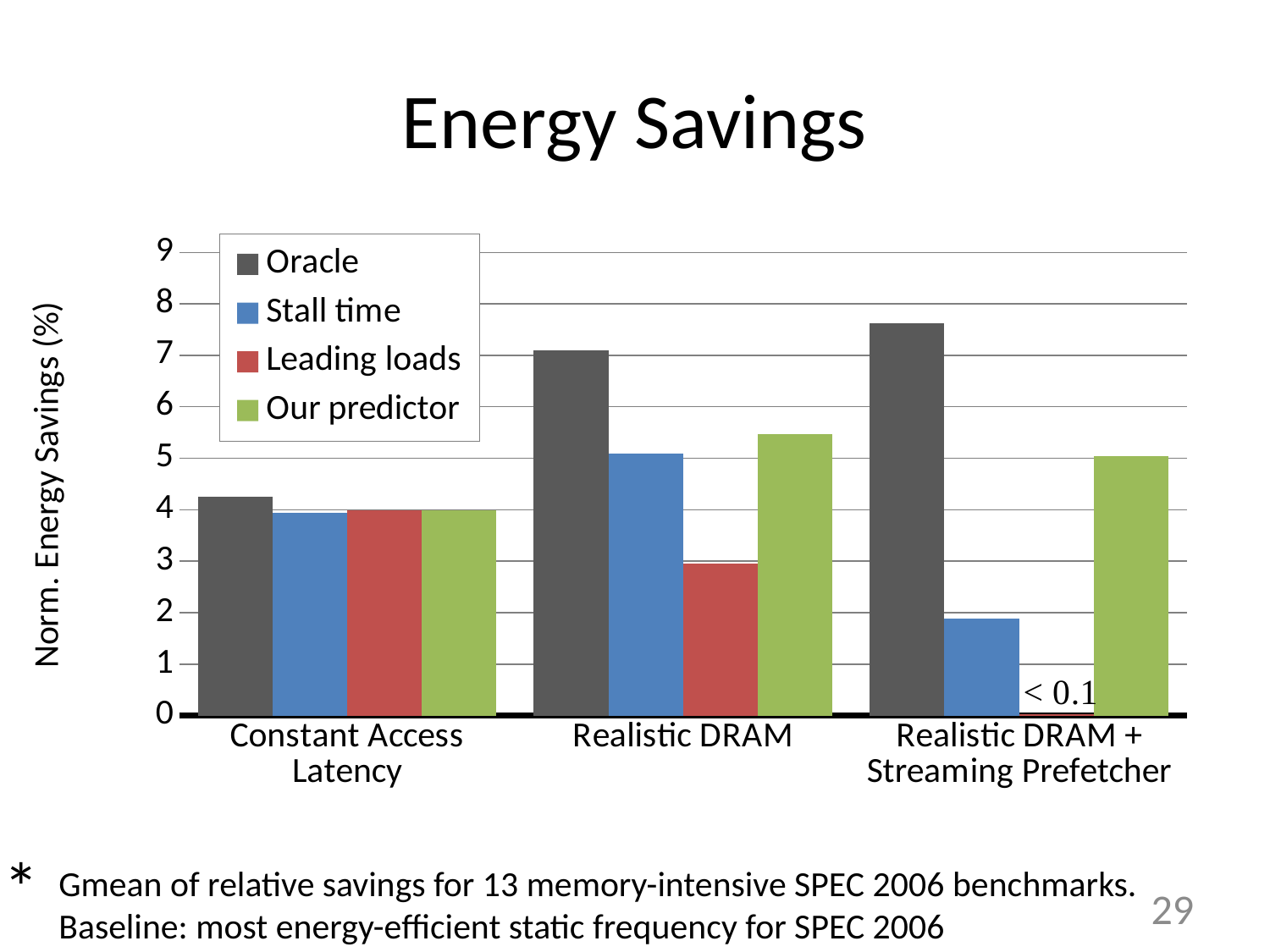
In the Realistic DRAM category, which is larger: Stall time or Leading loads? Stall time In the Realistic DRAM category, which is larger: Our predictor or Stall time? Our predictor What kind of chart is shown on the slide? bar chart Is the Stall time value for Realistic DRAM + Streaming Prefetcher greater or less than 2? less Do the Oracle values rise or fall moving from Constant Access Latency to Realistic DRAM + Streaming Prefetcher? rise Which series has the lowest value in the Realistic DRAM + Streaming Prefetcher category? Leading loads How many series does the legend list? 4 How many categories are shown along the x axis? 3 What is the title of the chart? Energy Savings What is the label of the y axis? Norm. Energy Savings (%) Which series has the highest value in the Realistic DRAM + Streaming Prefetcher category? Oracle